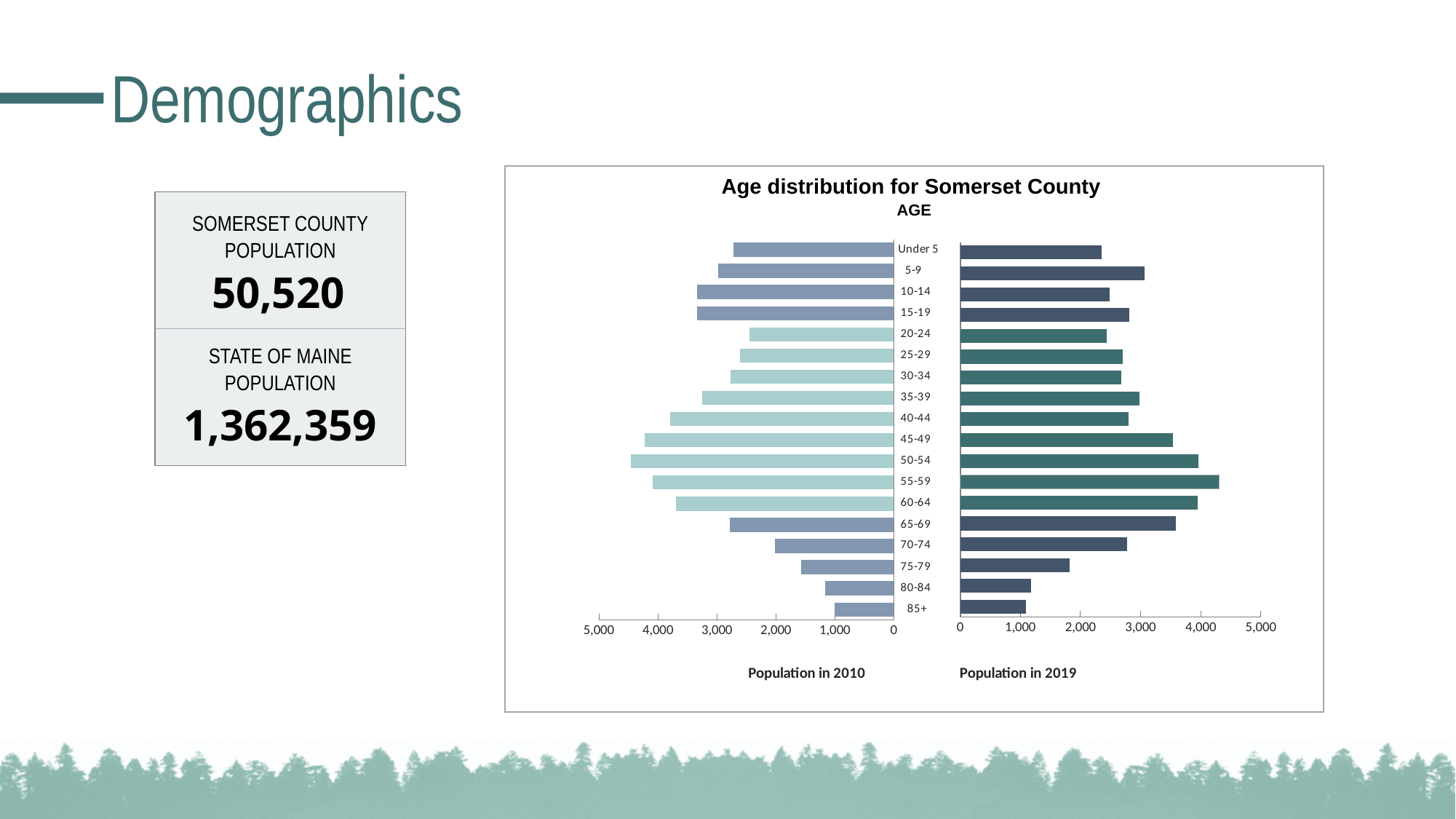
What kind of chart is used to show the age distribution for Somerset County? bar chart How many population series does the age distribution chart show? 2 What is the title of the chart on the slide? Age distribution for Somerset County Is the 2010 population for the 20-24 age group greater or less than 3,000? less Which age group has the largest population in 2010 in the age distribution chart? 50-54 For the 50-54 age group, which is larger: the population in 2010 or the population in 2019? Population in 2010 Is the 2010 population for the 50-54 age group greater or less than 4,000? greater How many age groups are shown in the age distribution chart? 18 Is the 2019 population for the 75-79 age group greater or less than 2,000? less For the 65-69 age group, which is larger: the population in 2010 or the population in 2019? Population in 2019 Which age group has the largest population in 2019 in the age distribution chart? 55-59